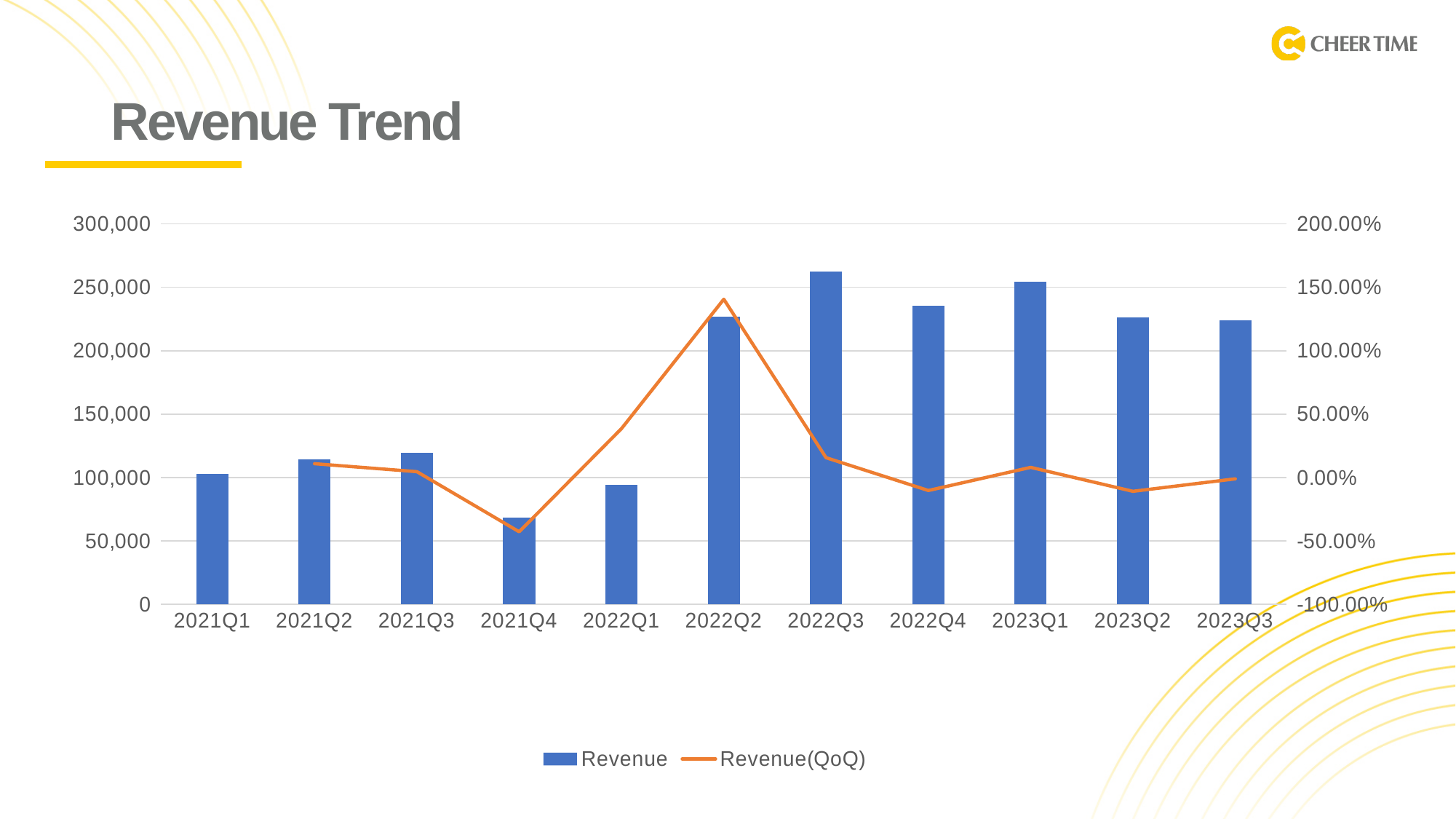
Is the Revenue for 2021Q4 greater or less than 100,000? less Is the Revenue for 2022Q1 greater or less than 100,000? less How many quarters are shown on the x axis? 11 What kind of chart is shown on the slide? Combined bar and line chart Is the Revenue for 2022Q3 greater or less than 250,000? greater Which quarter has the lowest Revenue bar? 2021Q4 Which quarter has the highest Revenue bar? 2022Q3 Which quarter is larger in Revenue, 2022Q2 or 2021Q3? 2022Q2 How many series does the legend list? 2 In which quarter does the Revenue(QoQ) line reach its peak? 2022Q2